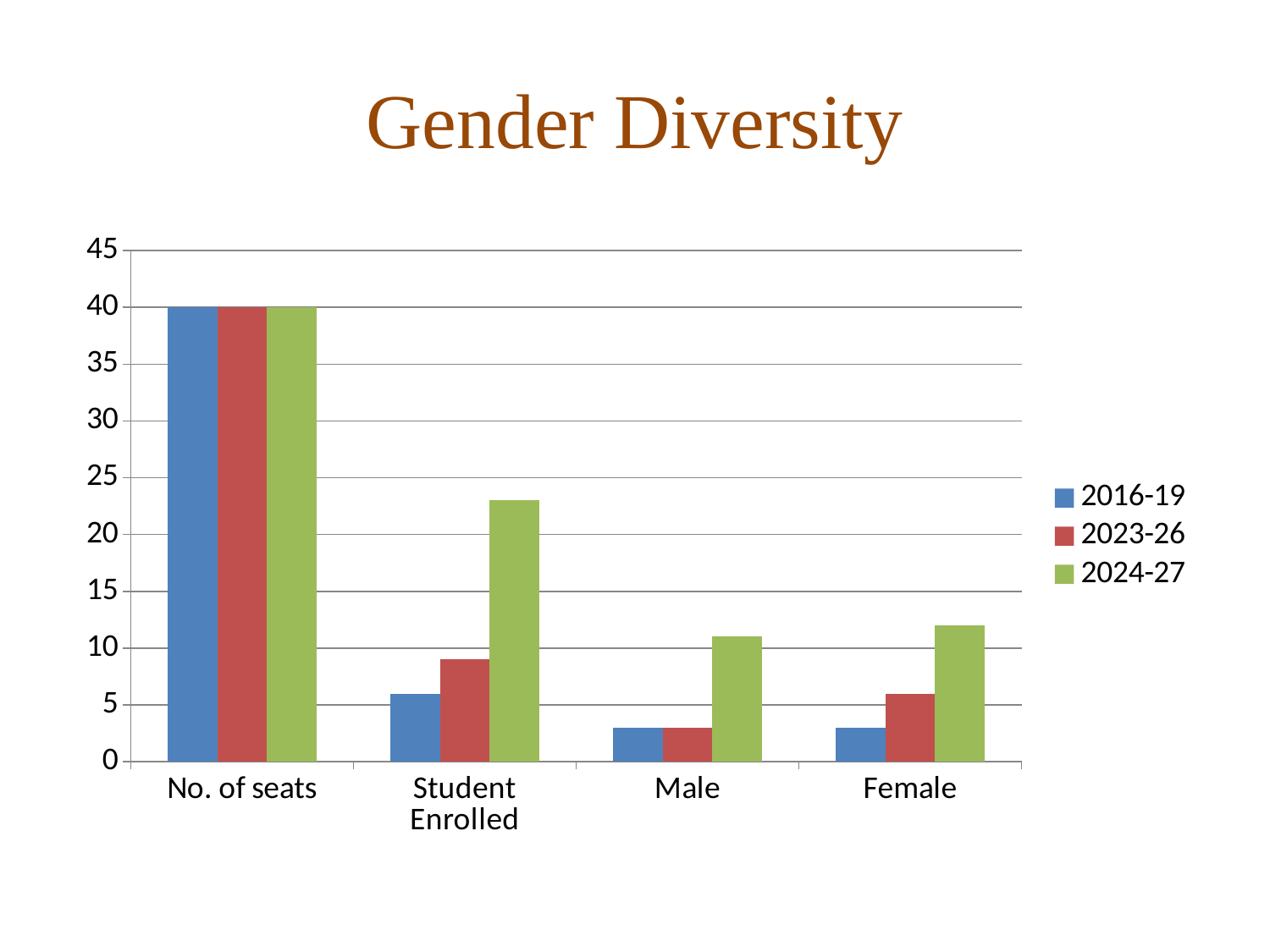
Which category has the highest values across all series? No. of seats Is the value for Student Enrolled in the 2023-26 series greater or less than 10? less How many categories are shown on the x axis? 4 What is the title of the chart? Gender Diversity What is the value for No. of seats in the 2016-19 series? 40 For Female, which series has the larger value: 2023-26 or 2024-27? 2024-27 What is the value for No. of seats in the 2024-27 series? 40 How many series does the legend list? 3 Is the value for Male in the 2024-27 series greater or less than 10? greater Which series is shown in green? 2024-27 What type of chart is shown on the slide? bar chart Is the value for Student Enrolled in the 2024-27 series greater or less than 20? greater